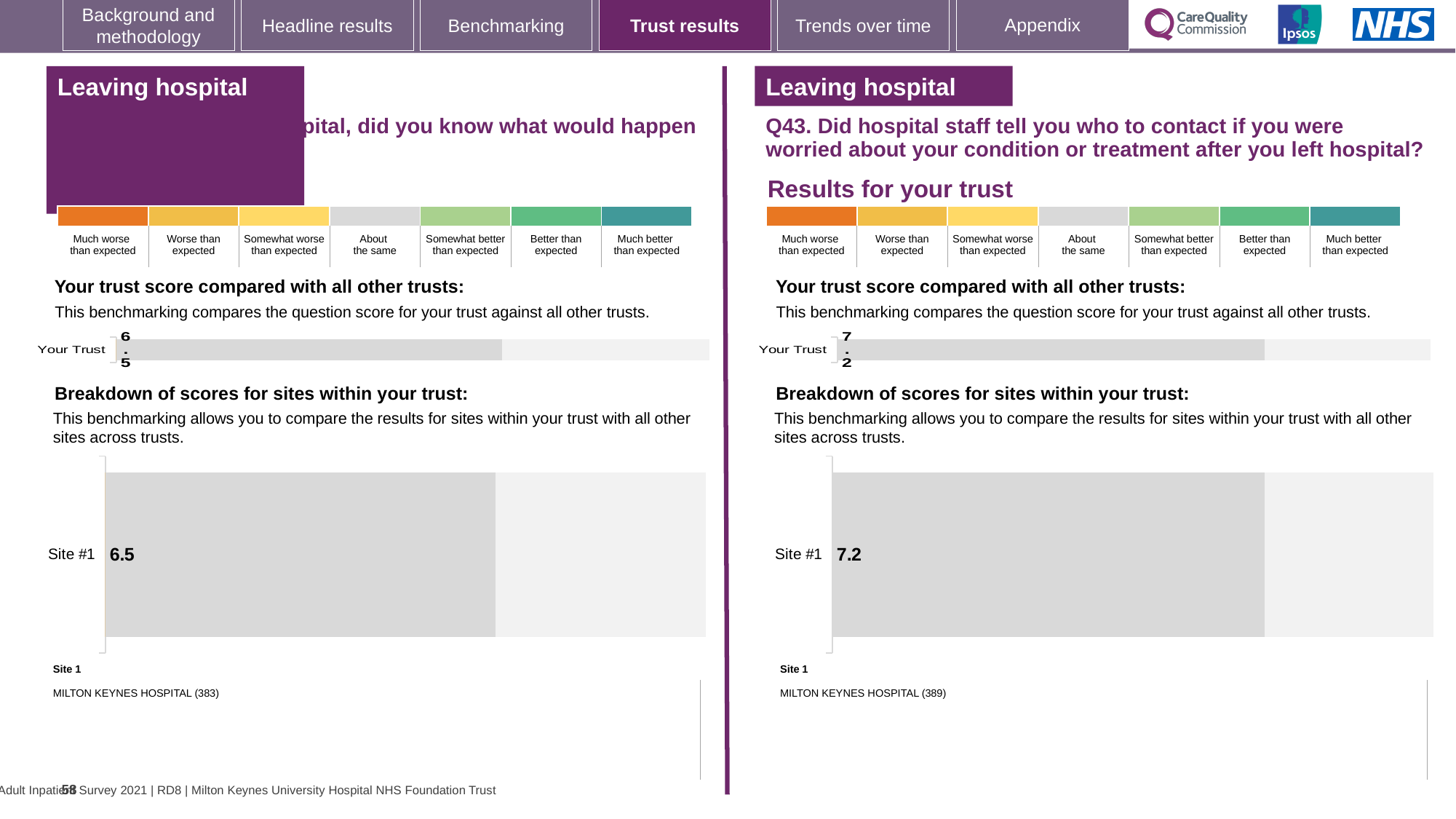
What is the difference between the Site #1 score on the right half of the slide (Q43) and the Site #1 score on the left half? 0.7 On the left half of the slide, what is the value shown for Your Trust in the 'Your trust score compared with all other trusts' chart? 6.5 On the right half of the slide (Q43), what score is shown for Site #1 in the 'Breakdown of scores for sites within your trust' chart? 7.2 On the left half of the slide, which site name is listed under Site 1 below the breakdown chart? MILTON KEYNES HOSPITAL (383) How many sites are shown in the 'Breakdown of scores for sites within your trust' chart on the left half of the slide? 1 On the right half of the slide (Q43), what is the value shown for Your Trust in the 'Your trust score compared with all other trusts' chart? 7.2 On the right half of the slide (Q43), which site name is listed under Site 1 below the breakdown chart? MILTON KEYNES HOSPITAL (389) What type of chart is used to show the Site #1 score on the right half of the slide (Q43)? Bar chart How many sites are shown in the 'Breakdown of scores for sites within your trust' chart on the right half of the slide (Q43)? 1 On the left half of the slide, what score is shown for Site #1 in the 'Breakdown of scores for sites within your trust' chart? 6.5 Which is larger: the Your Trust score on the left half of the slide or the Your Trust score on the right half (Q43)? Right half (Q43)